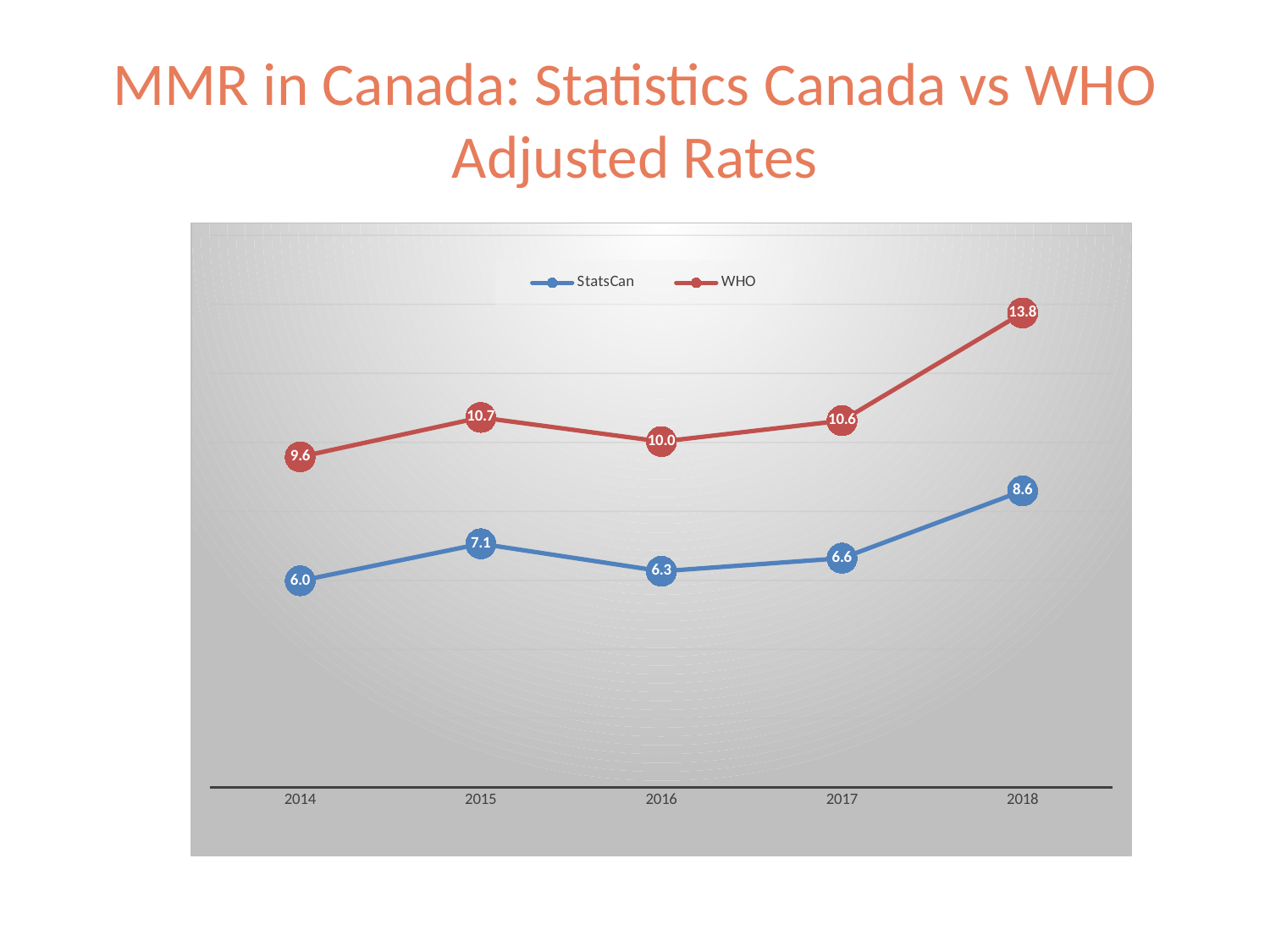
How many series does the legend list? 2 In which year is the StatsCan series highest? 2018 In which year is the WHO series lowest? 2014 What kind of chart is shown on the slide? Line chart What is the difference between the WHO and StatsCan values in 2018? 5.2 Which is larger in 2017, the WHO value or the StatsCan value? WHO What is the WHO value for 2015? 10.7 Does the WHO series rise or fall from 2017 to 2018? Rise What is the WHO value for 2018? 13.8 What is the StatsCan value for 2014? 6.0 How many years are shown on the x axis? 5 What is the StatsCan value for 2016? 6.3